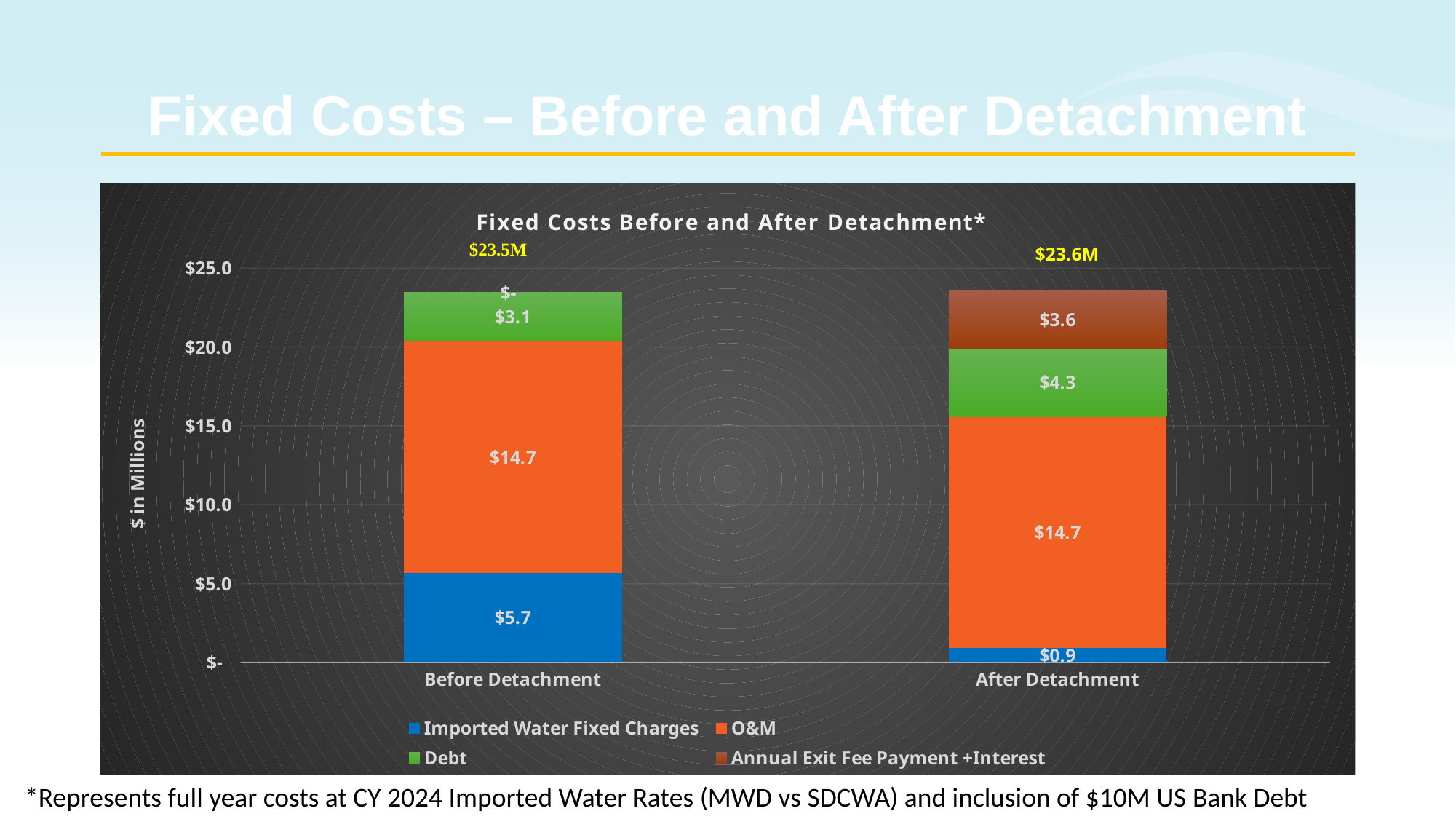
What is the value of Annual Exit Fee Payment +Interest for After Detachment? $3.6 How many categories are shown on the x axis? 2 What is the value of Debt for After Detachment? $4.3 What is the total fixed cost shown above the After Detachment bar? $23.6M What type of chart is shown on the slide? Stacked bar chart What is the total fixed cost shown above the Before Detachment bar? $23.5M Which category has the larger Debt value, Before Detachment or After Detachment? After Detachment What is the label of the y axis? $ in Millions What is the difference in Imported Water Fixed Charges between Before Detachment and After Detachment? $4.8 What is the value of Imported Water Fixed Charges for Before Detachment? $5.7 What is the value of O&M for Before Detachment? $14.7 How many series does the legend list? 4